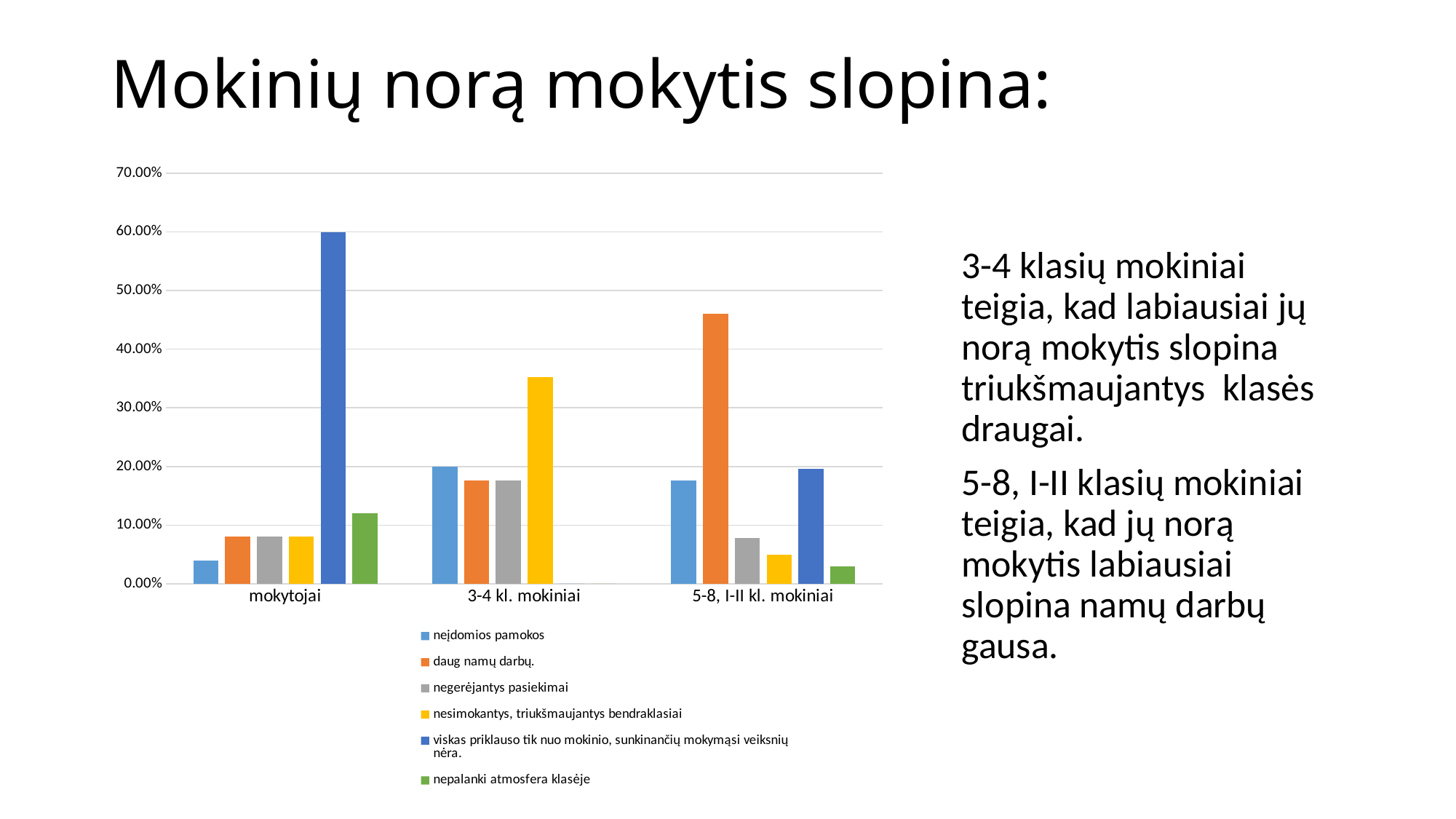
Which series has the highest value for the '5-8, I-II kl. mokiniai' category? daug namų darbų. How many categories are shown on the x axis of the chart? 3 What kind of chart is shown on the slide? bar chart How many series does the chart legend list? 6 Which series has the highest value for the '3-4 kl. mokiniai' category? nesimokantys, triukšmaujantys bendraklasiai Is the value for 'nepalanki atmosfera klasėje' in the 'mokytojai' category greater or less than 10.00%? greater Is the value for 'daug namų darbų.' in the '5-8, I-II kl. mokiniai' category greater or less than 40.00%? greater Which series has the highest value for the 'mokytojai' category? viskas priklauso tik nuo mokinio, sunkinančių mokymąsi veiksnių nėra. Is the value for 'neįdomios pamokos' in the 'mokytojai' category greater or less than 10.00%? less What is the title of the slide containing the chart? Mokinių norą mokytis slopina: For the '3-4 kl. mokiniai' category, which is larger: 'nesimokantys, triukšmaujantys bendraklasiai' or 'daug namų darbų.'? nesimokantys, triukšmaujantys bendraklasiai